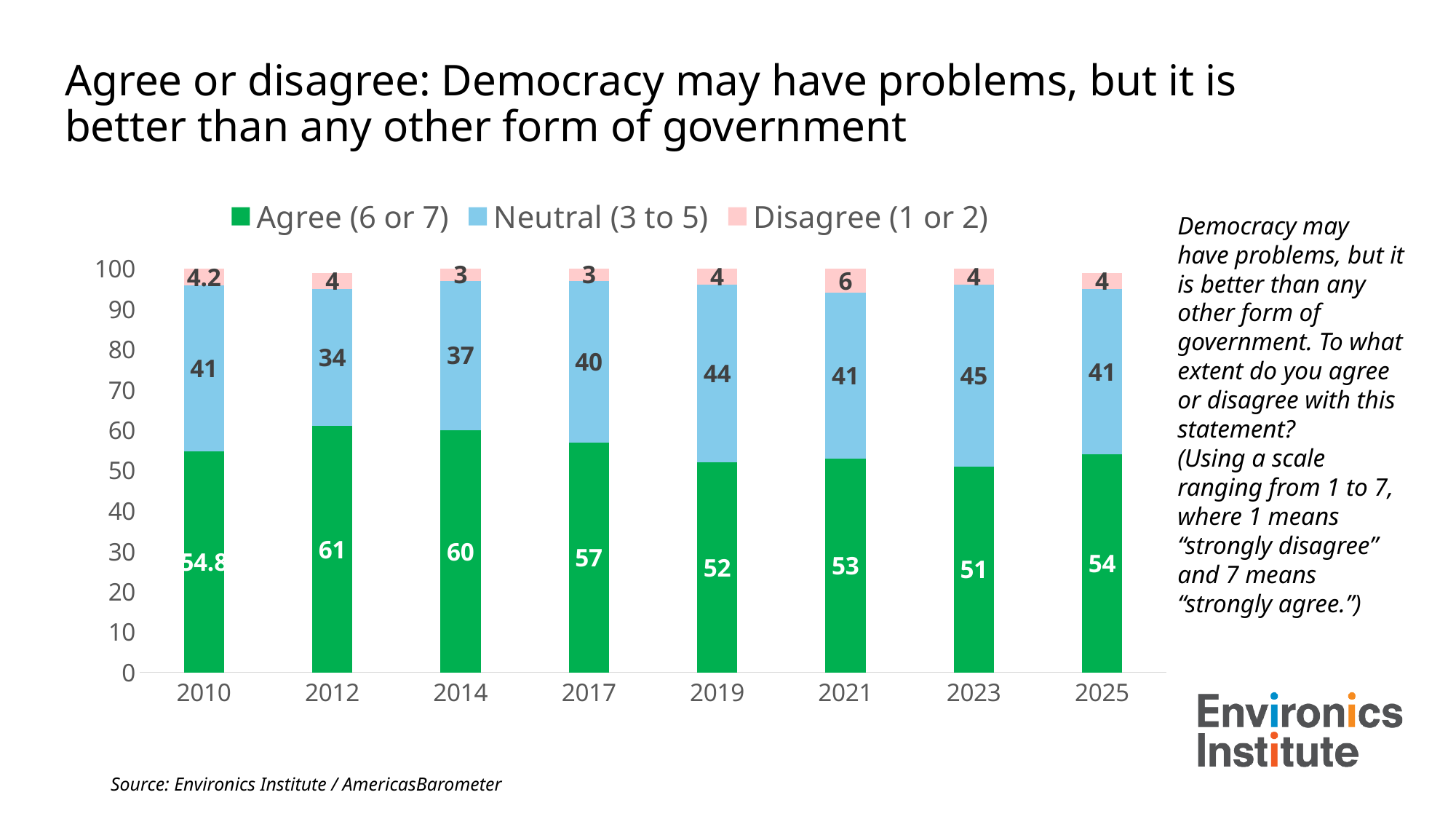
What is the Agree (6 or 7) value for 2010? 54.8 Which year has the highest Disagree (1 or 2) value? 2021 What is the difference between the Agree (6 or 7) values for 2012 and 2023? 10 Is the Neutral (3 to 5) value larger in 2023 or in 2012? 2023 How many series does the legend list? 3 What is the Neutral (3 to 5) value for 2019? 44 How many years are shown on the x axis? 8 What is the Disagree (1 or 2) value for 2021? 6 Which year has the highest Agree (6 or 7) value? 2012 What kind of chart is shown on the slide? Stacked bar chart What is the Agree (6 or 7) value for 2012? 61 Which year has the lowest Agree (6 or 7) value? 2023